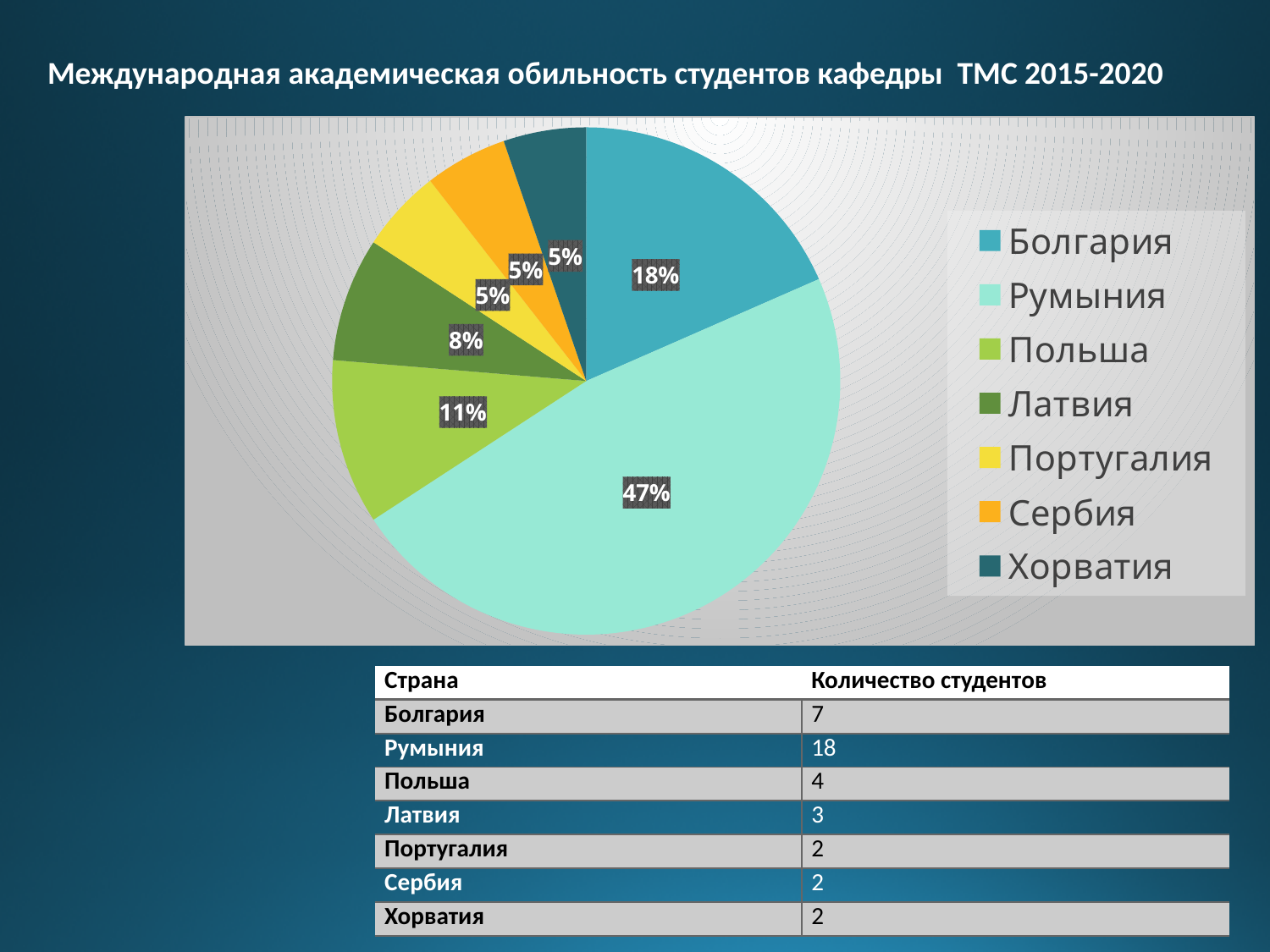
What share of the pie does Латвия have? 8% What share of the pie does Польша have? 11% What kind of chart is shown on the slide? pie chart How many entries does the legend list? 7 Which slice is larger, Болгария or Польша? Болгария What is the difference in percentage points between the Румыния slice and the Болгария slice? 29 Which legend entry is shown in orange? Сербия How many slices does the pie chart have? 7 What share of the pie does Сербия have? 5% Which country has the largest slice of the pie? Румыния